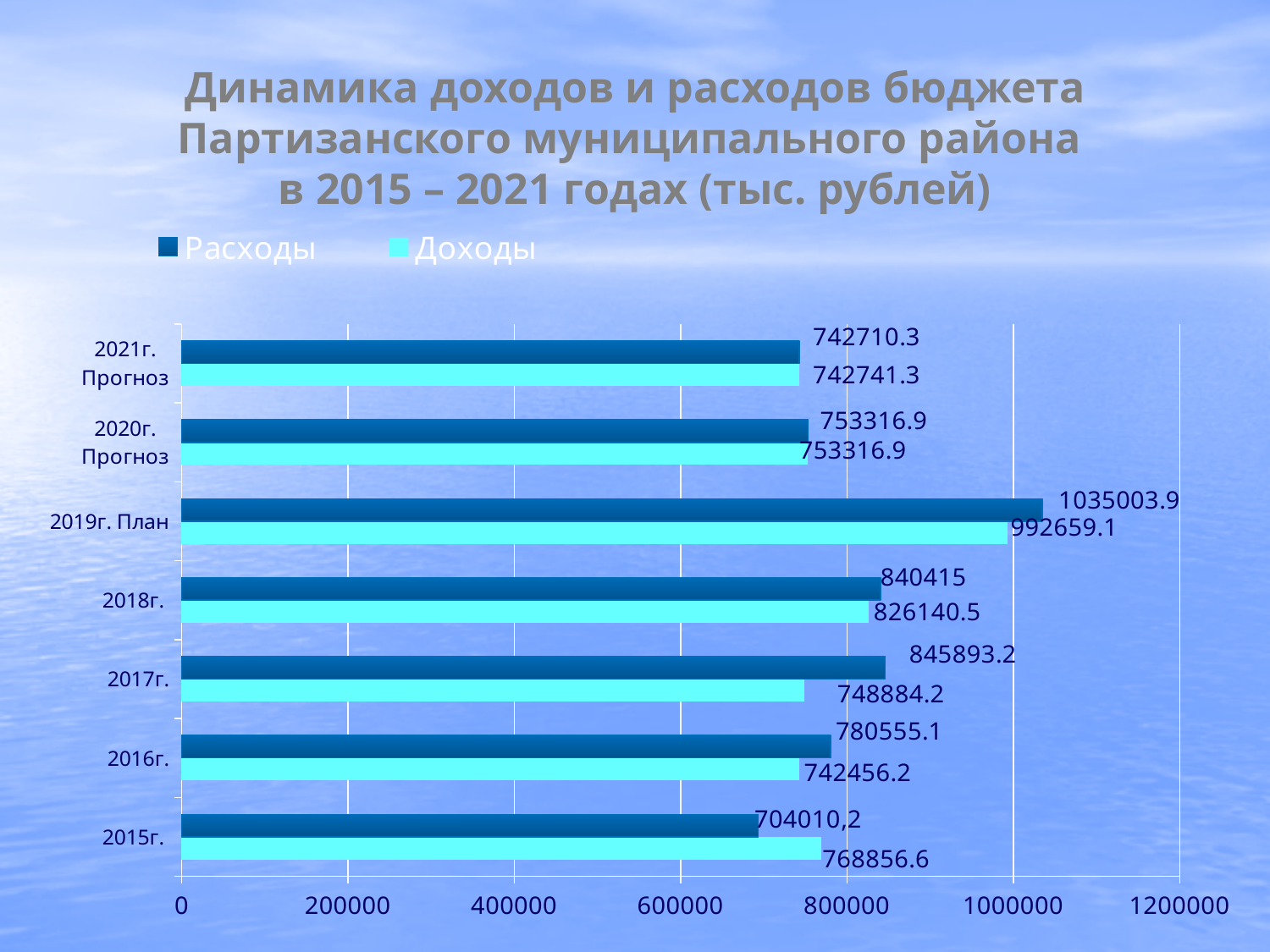
What is the value of Расходы for 2021г. Прогноз? 742710.3 How many series does the legend list? 2 What is the value of Расходы for 2019г. План? 1035003.9 How many categories (years) are shown on the chart? 7 What is the difference between Расходы and Доходы for 2017г.? 97009 Which category has the highest value of Расходы? 2019г. План What is the difference between Расходы and Доходы for 2019г. План? 42344.8 Which category has the lowest value of Расходы? 2015г. What is the value of Доходы for 2017г.? 748884.2 For 2015г., which is larger: Расходы or Доходы? Доходы Is the value of Расходы for 2019г. План greater or less than 1000000? greater What is the value of Доходы for 2015г.? 768856.6